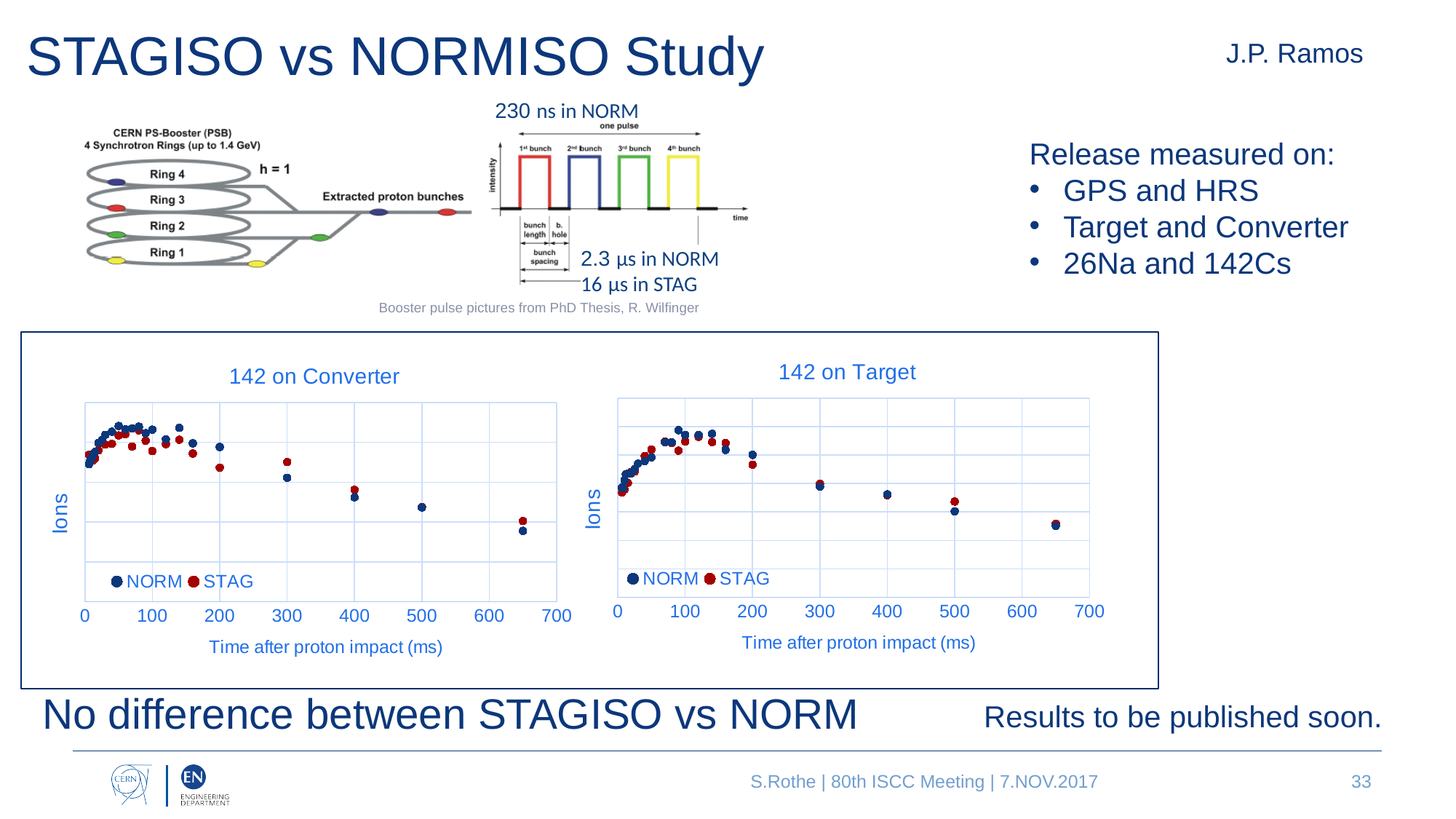
What is the largest tick value shown on the x axis of the "142 on Target" chart? 700 In the "142 on Target" chart, do the values rise or fall along the x axis between 0 ms and 100 ms? rise In the "142 on Target" chart, do the values rise or fall along the x axis between 200 ms and 650 ms? fall What kind of chart is the "142 on Converter" chart? scatter chart In the "142 on Converter" chart, is the NORM value at 650 ms higher or lower than the NORM value at 100 ms? lower In the "142 on Target" chart, is the STAG value at 100 ms higher or lower than the STAG value at 500 ms? higher How many series does the legend of the "142 on Converter" chart list? 2 What is the x-axis title of the "142 on Converter" chart? Time after proton impact (ms) In the "142 on Target" chart, which series is plotted in blue? NORM In the "142 on Converter" chart, do the values rise or fall along the x axis between 300 ms and 650 ms? fall What kind of chart is the "142 on Target" chart? scatter chart How many series does the legend of the "142 on Target" chart list? 2